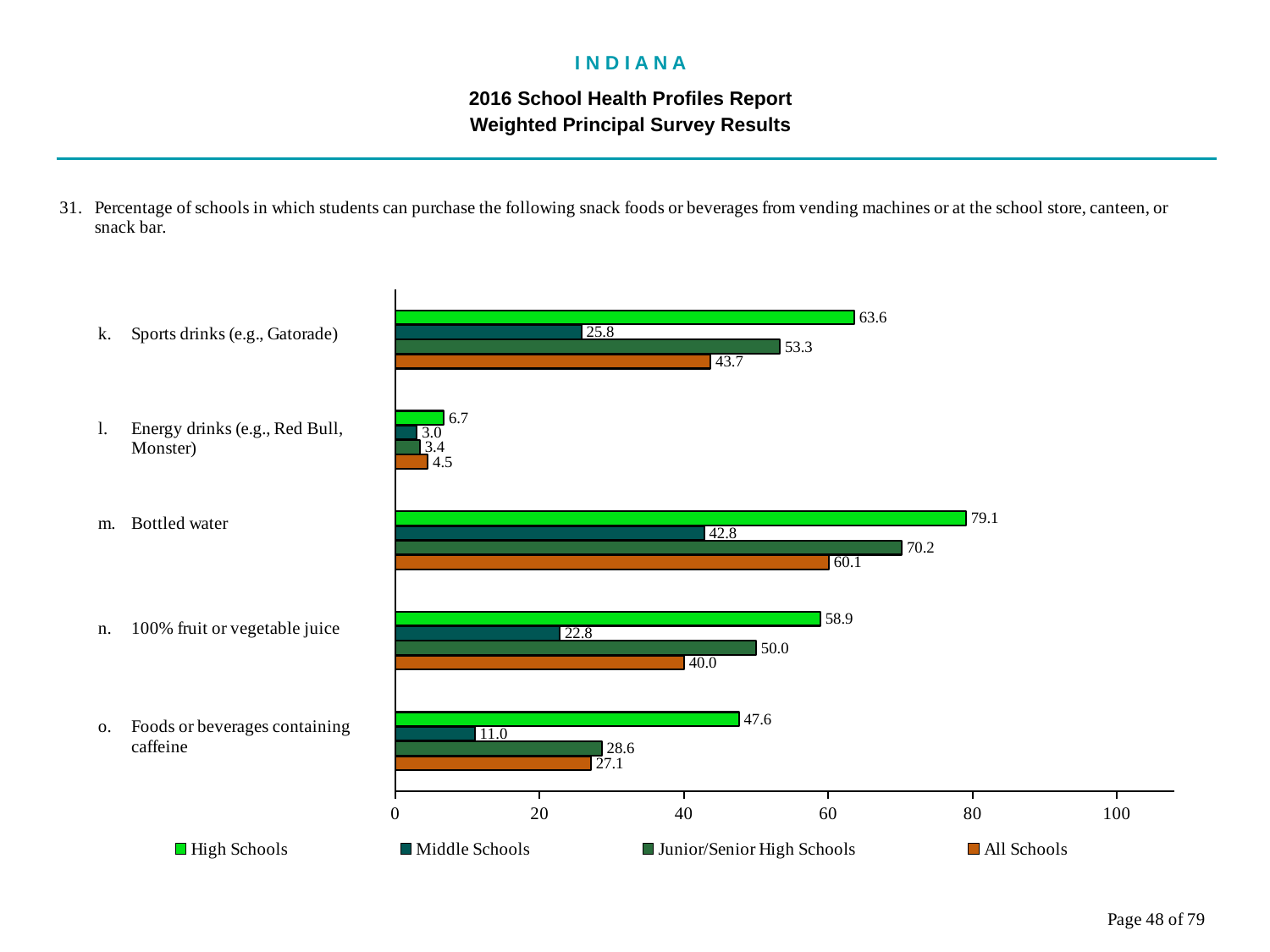
Which is larger for Sports drinks (e.g., Gatorade): the Junior/Senior High Schools value or the All Schools value? Junior/Senior High Schools What is the value for High Schools for Bottled water? 79.1 What is the value for All Schools for Foods or beverages containing caffeine? 27.1 Which category has the highest value for High Schools? Bottled water How many series does the legend list? 4 What is the value for Middle Schools for Sports drinks (e.g., Gatorade)? 25.8 What is the difference between the High Schools and Middle Schools values for Bottled water? 36.3 Is the value for High Schools for Foods or beverages containing caffeine greater or less than 40? greater What is the value for Junior/Senior High Schools for 100% fruit or vegetable juice? 50.0 What kind of chart is shown on the slide? Bar chart Which category has the lowest value for Middle Schools? Energy drinks (e.g., Red Bull, Monster) How many categories are shown on the chart? 5